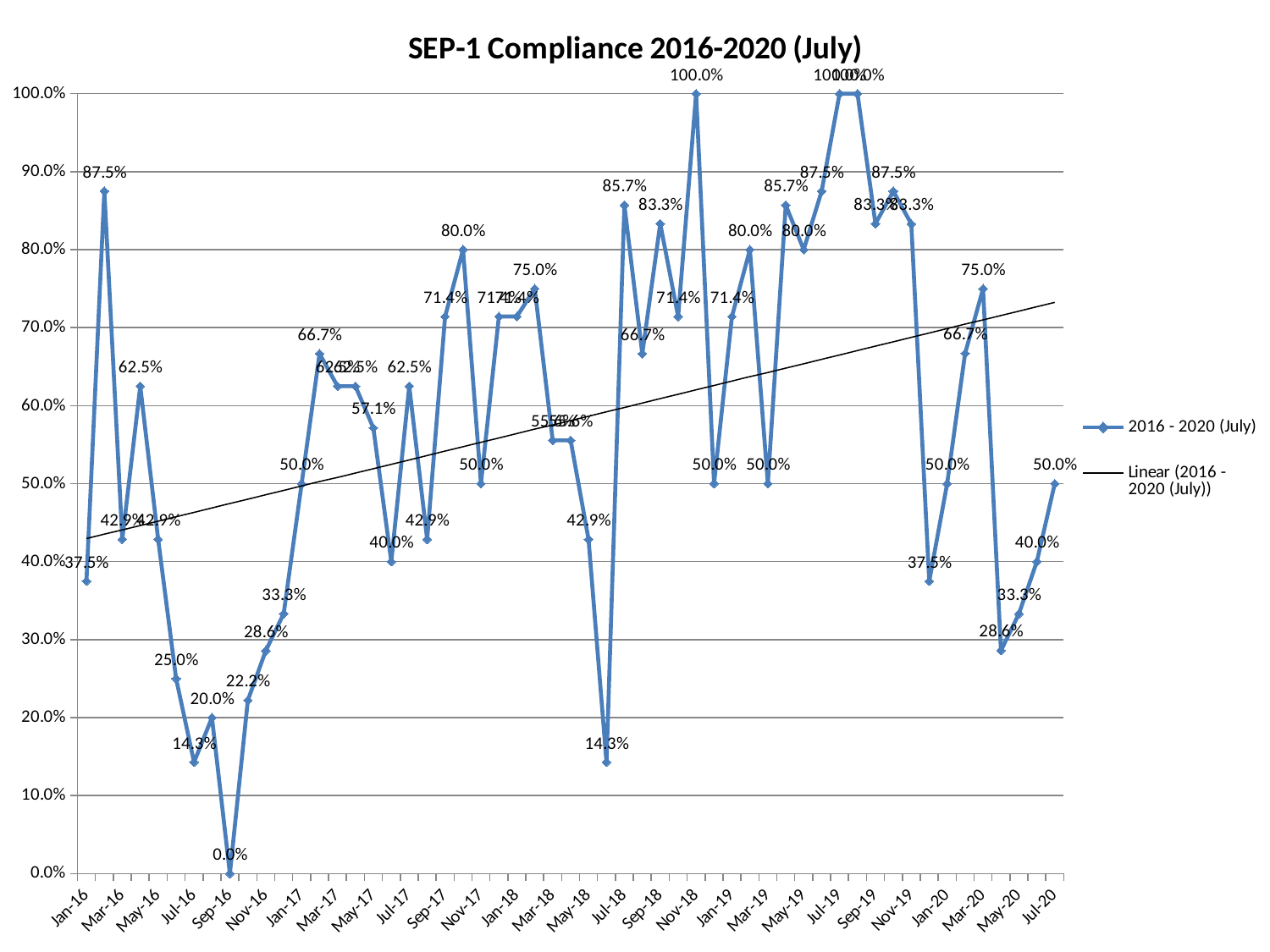
What is the compliance value for Sep-16? 0.0% Which month has the higher compliance value, Mar-20 or May-20? Mar-20 What is the title of the chart? SEP-1 Compliance 2016-2020 (July) What is the compliance value for Mar-20? 75.0% Which month has the lowest compliance value? Sep-16 What is the highest compliance value plotted on the chart? 100.0% What type of chart is shown on the slide? Line chart What is the difference between the compliance values for Jul-18 and Jul-16? 71.4% How many entries does the legend list? 2 What is the compliance value for Jan-16? 37.5% According to the linear trendline, does compliance rise or fall from Jan-16 to Jul-20? Rise What is the compliance value for Jul-20? 50.0%